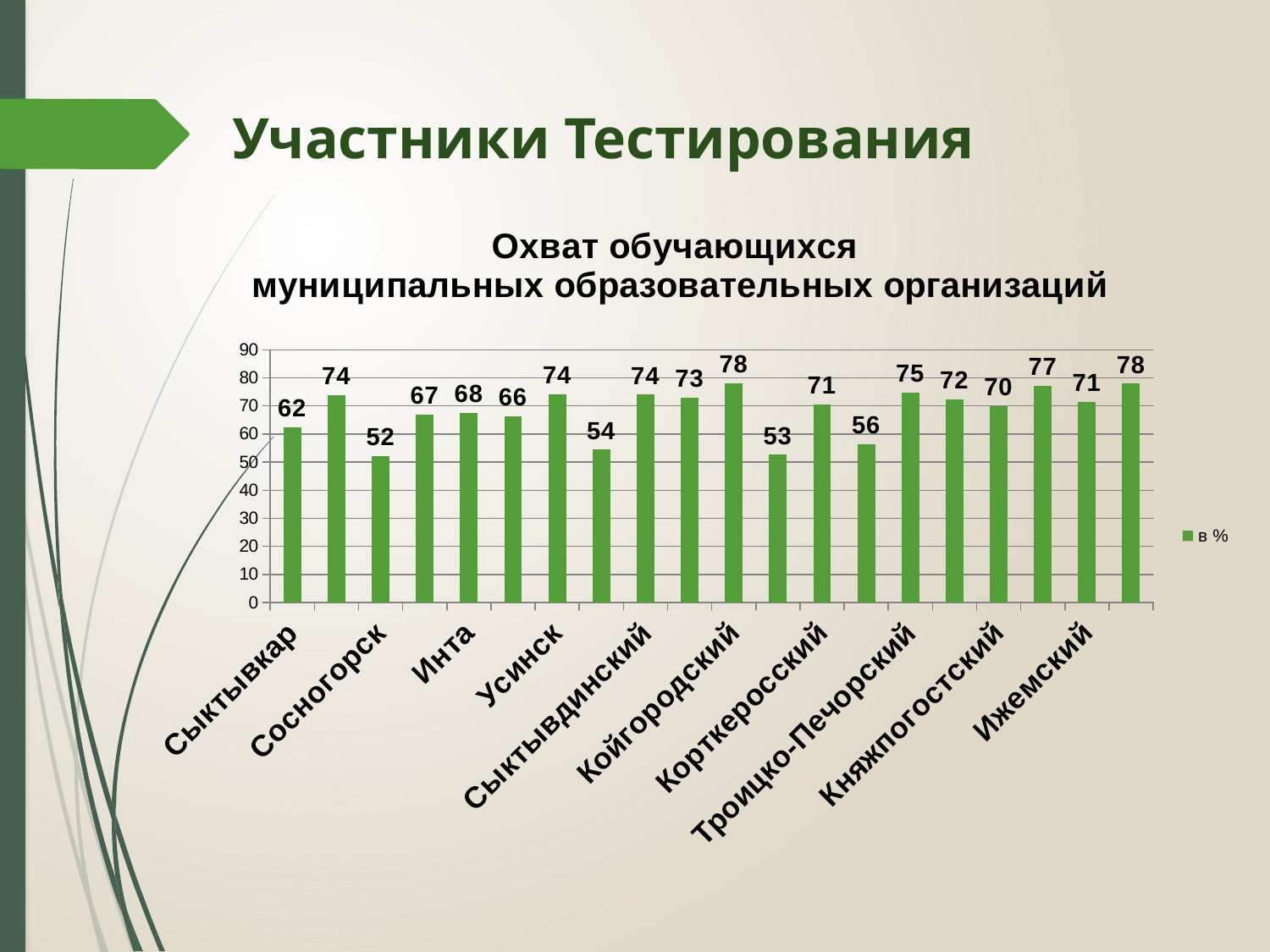
Is the value for Сосногорск greater or less than 60? less Which has a larger value, Койгородский or Сосногорск? Койгородский How many bars are plotted in the chart? 20 What is the lowest value shown in the chart? 52 What is the value for Сосногорск? 52 What is the value for Княжпогостский? 70 What is the value for Сыктывкар? 62 What is the value for Троицко-Печорский? 75 What is the difference between the values for Сыктывкар and Сосногорск? 10 What is the value for Койгородский? 78 What label does the legend show for the series? в % What type of chart is shown on the slide? bar chart